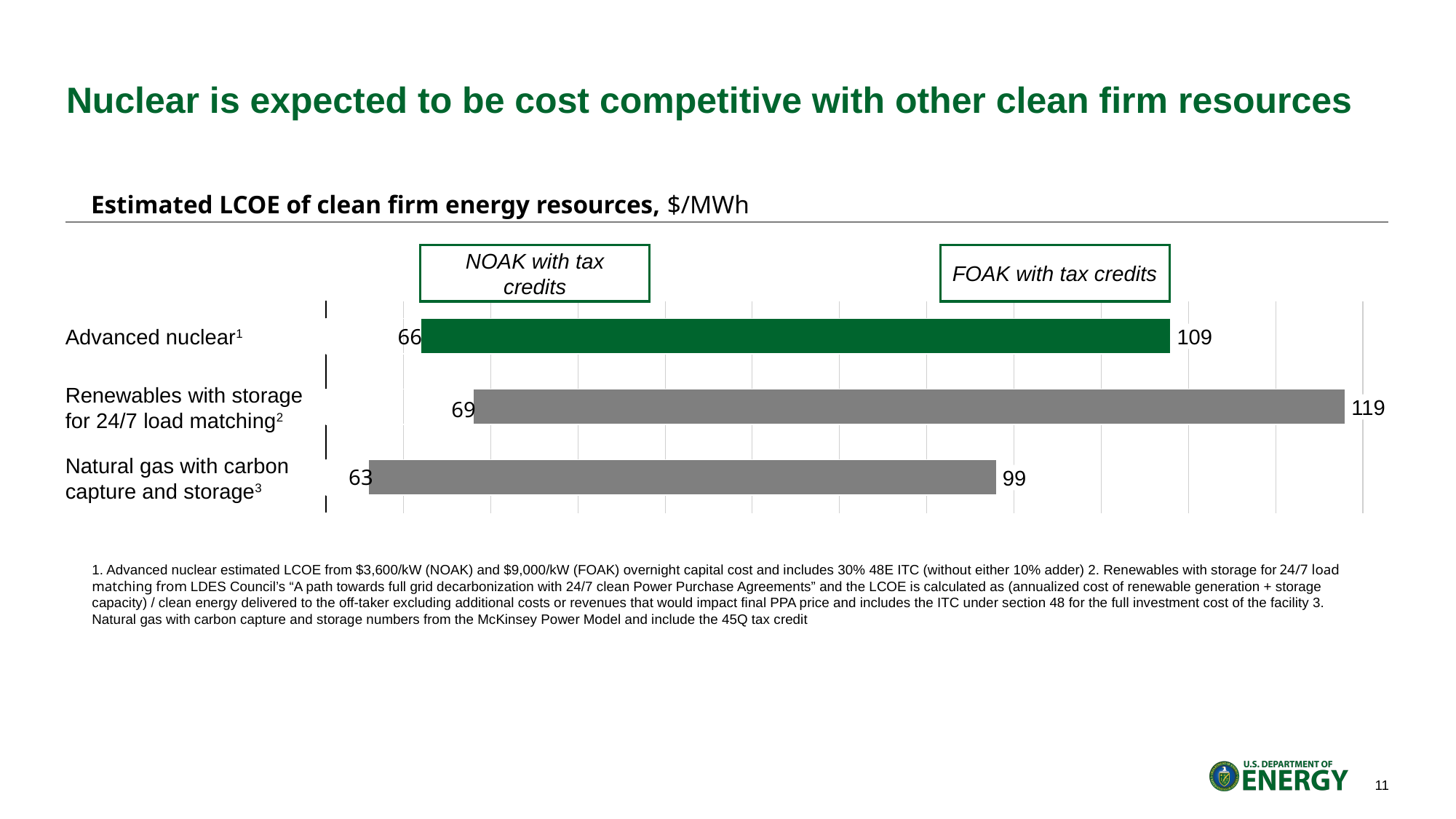
What is the difference between the high and low estimated LCOE values for Advanced nuclear? 43 What type of chart is used to show the estimated LCOE ranges? Bar chart What is the upper value of the range shown for Renewables with storage for 24/7 load matching? 119 How many energy resources are shown in the chart? 3 Which is larger: the upper-end LCOE for Advanced nuclear or for Natural gas with carbon capture and storage? Advanced nuclear What is the lower value of the range shown for Natural gas with carbon capture and storage? 63 What is the high-end (FOAK with tax credits) estimated LCOE for Advanced nuclear? 109 What is the low-end (NOAK with tax credits) estimated LCOE for Advanced nuclear? 66 What unit is the estimated LCOE expressed in, according to the chart title? $/MWh How much higher is the upper-end LCOE of Renewables with storage than the upper-end LCOE of Natural gas with carbon capture and storage? 20 Which resource has the highest upper-end estimated LCOE? Renewables with storage for 24/7 load matching Which resource has the lowest lower-end estimated LCOE? Natural gas with carbon capture and storage